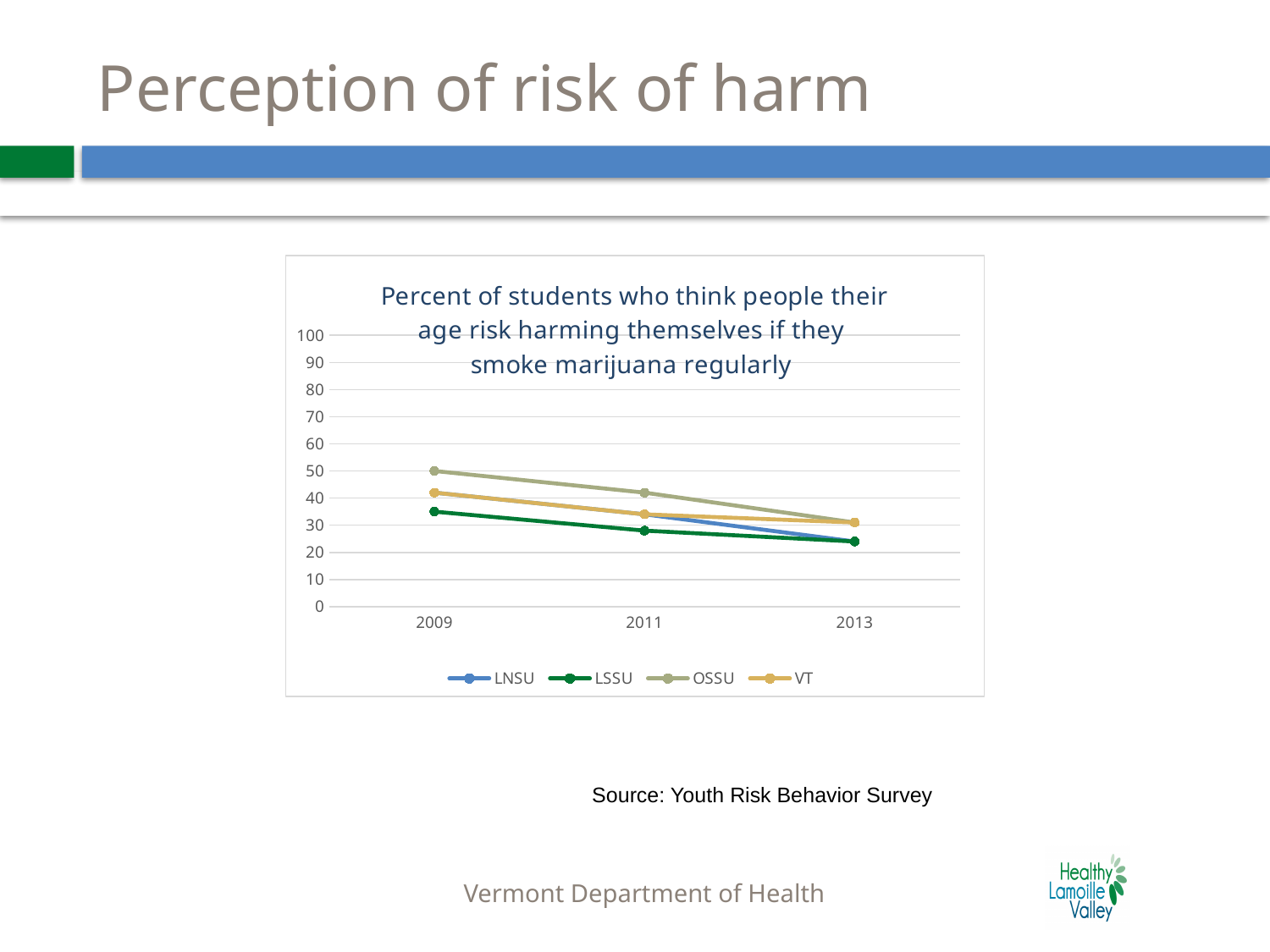
Which series has the lowest value in 2011? LSSU Is the value for LSSU in 2009 greater or less than 40? less Do the values for OSSU rise or fall from 2009 to 2013? fall What kind of chart is shown on the slide? line chart Is the value for OSSU in 2009 greater or less than 40? greater Which series has the highest value in 2009? OSSU Is the value for OSSU in 2011 greater or less than 50? less What is the title of the chart? Percent of students who think people their age risk harming themselves if they smoke marijuana regularly How many years are plotted along the x axis? 3 Which is larger in 2009, the value for OSSU or the value for LSSU? OSSU How many series does the legend list? 4